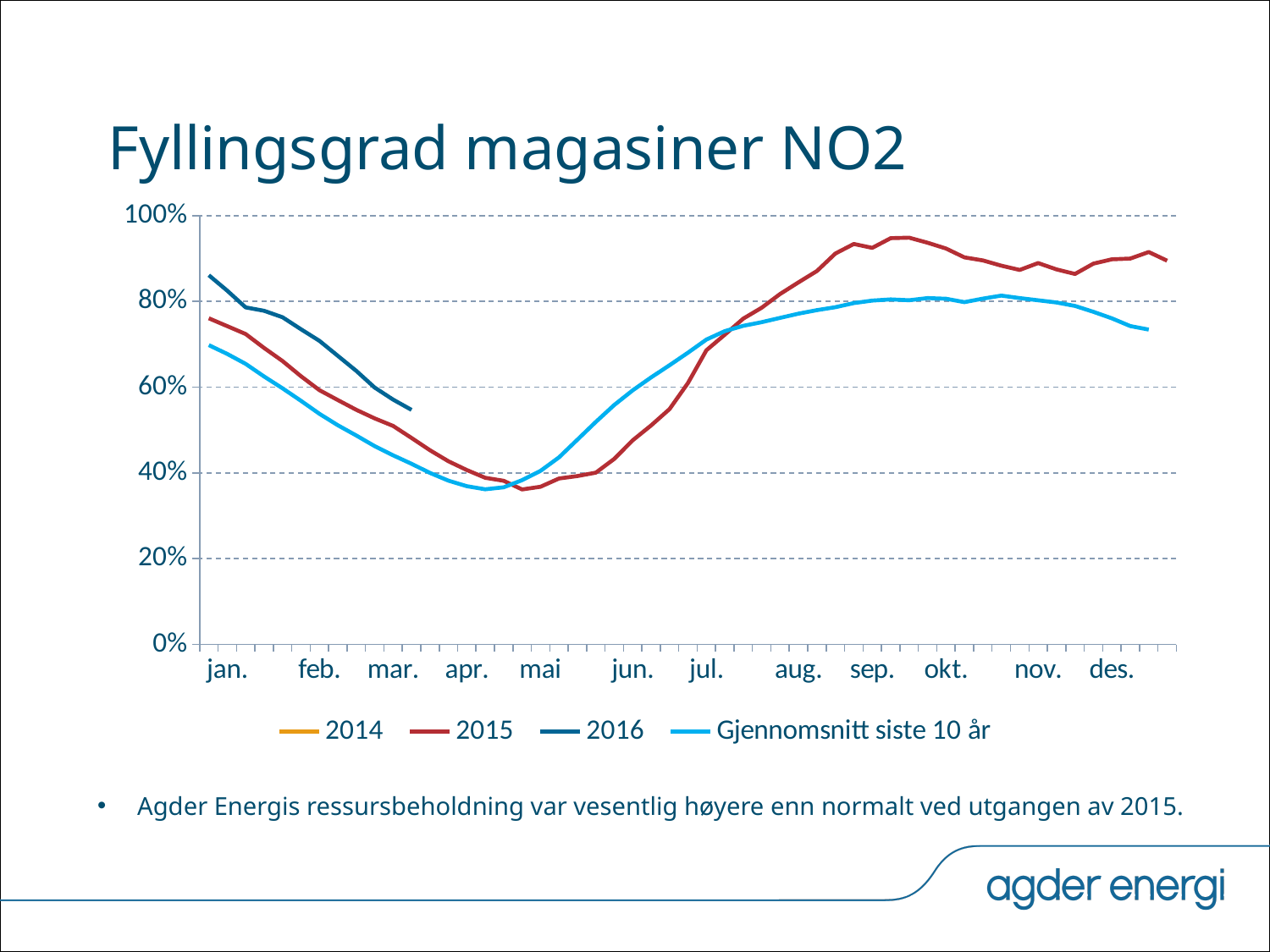
Is the value for 2015 in September greater or less than 80%? greater Is the value for 2016 at the start of January greater or less than 80%? greater Is the value for Gjennomsnitt siste 10 år in April greater or less than 40%? less What is the title of the chart? Fyllingsgrad magasiner NO2 At the start of January, which series is higher, 2016 or 2015? 2016 What kind of chart is shown on the slide? line chart Which legend entry is drawn in light blue? Gjennomsnitt siste 10 år Does the 2015 series rise or fall from January to April? fall How many month labels are shown on the x axis? 12 In September, which series is higher, 2015 or Gjennomsnitt siste 10 år? 2015 How many series does the legend list? 4